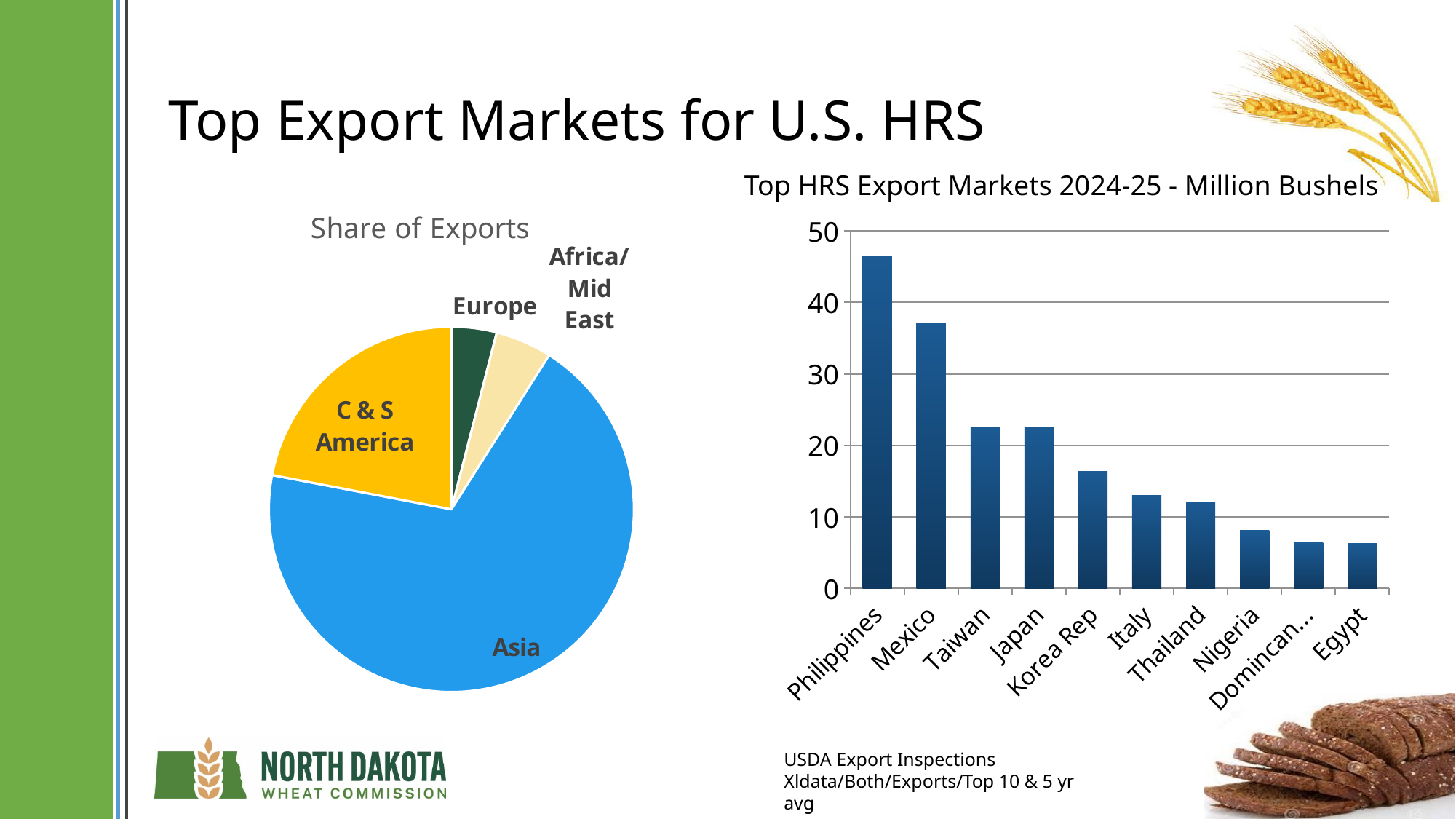
In the 'Top HRS Export Markets 2024-25 - Million Bushels' chart, is the value for Korea Rep greater or less than 20? less In the 'Top HRS Export Markets 2024-25 - Million Bushels' chart, is the value for Nigeria greater or less than 10? less How many slices does the 'Share of Exports' pie chart have? 4 What kind of chart is the 'Share of Exports' chart on the left? pie chart In the 'Share of Exports' pie chart, which region has the largest share? Asia In the 'Top HRS Export Markets 2024-25 - Million Bushels' chart, which country has the highest value? Philippines In the 'Top HRS Export Markets 2024-25 - Million Bushels' chart, how many countries are shown on the x axis? 10 In the 'Top HRS Export Markets 2024-25 - Million Bushels' chart, is the value for Mexico greater or less than 40? less What kind of chart is the chart on the right titled 'Top HRS Export Markets 2024-25 - Million Bushels'? bar chart In the 'Top HRS Export Markets 2024-25 - Million Bushels' chart, which is larger, the value for Philippines or the value for Mexico? Philippines In the 'Top HRS Export Markets 2024-25 - Million Bushels' chart, do the values rise or fall moving from left to right along the x axis? fall